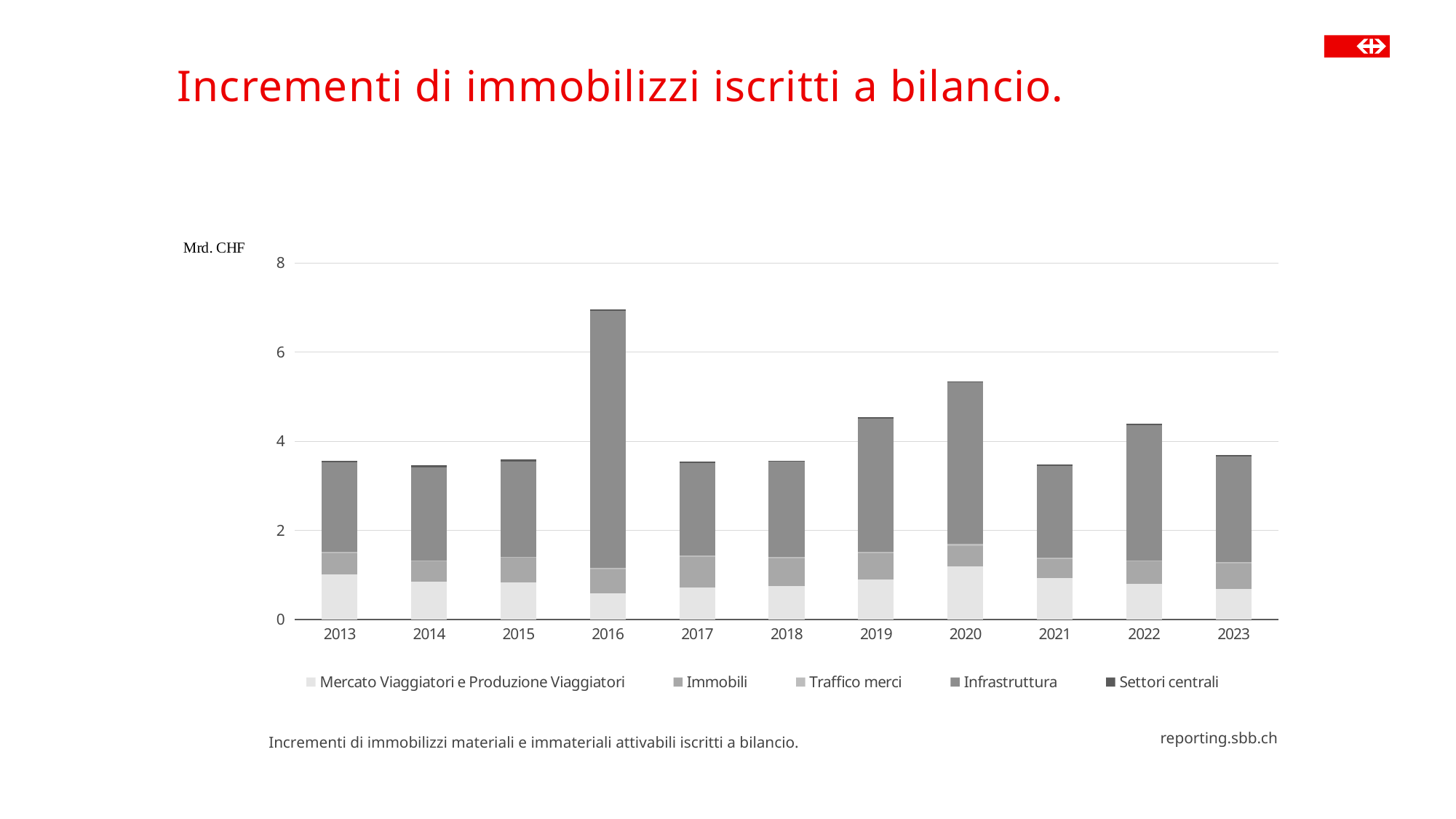
How many years are shown on the x axis of the chart? 11 Is the total value for 2020 greater or less than 4? greater Which year has the larger total bar, 2019 or 2020? 2020 What kind of chart is shown on the slide? stacked bar chart Which year has the highest total bar in the chart? 2016 Which year has the larger total bar, 2016 or 2020? 2016 What is the first entry in the chart legend? Mercato Viaggiatori e Produzione Viaggiatori What unit is shown on the y axis of the chart? Mrd. CHF Is the total value for 2023 greater or less than 4? less How many series does the chart legend list? 5 Is the total value for 2013 greater or less than 4? less